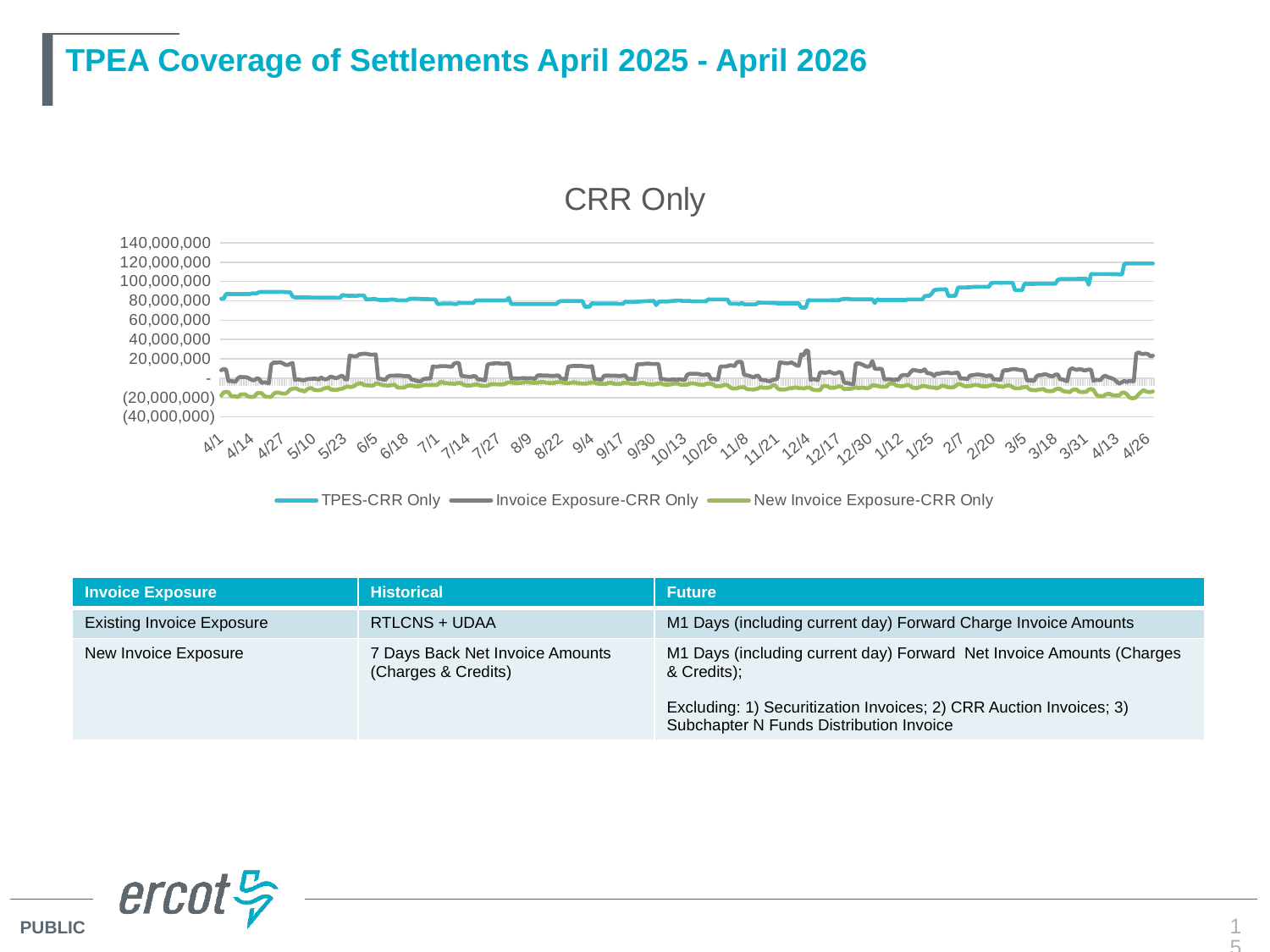
Which series has the highest values across the whole chart? TPES-CRR Only Is the TPES-CRR Only line higher at 4/1 or at 4/26? 4/26 Which series in the chart is drawn in blue? TPES-CRR Only Is the value of New Invoice Exposure-CRR Only at 10/13 greater or less than 20,000,000? less Is the value of TPES-CRR Only at 4/26 greater or less than 100,000,000? greater Is the value of TPES-CRR Only at 4/1 greater or less than 60,000,000? greater How many series does the legend of the chart list? 3 Which series has the lowest values across the whole chart? New Invoice Exposure-CRR Only Does the TPES-CRR Only line rise or fall overall from 4/1 to 4/26? rise What kind of chart is shown on the slide? line chart What is the title of the chart? CRR Only